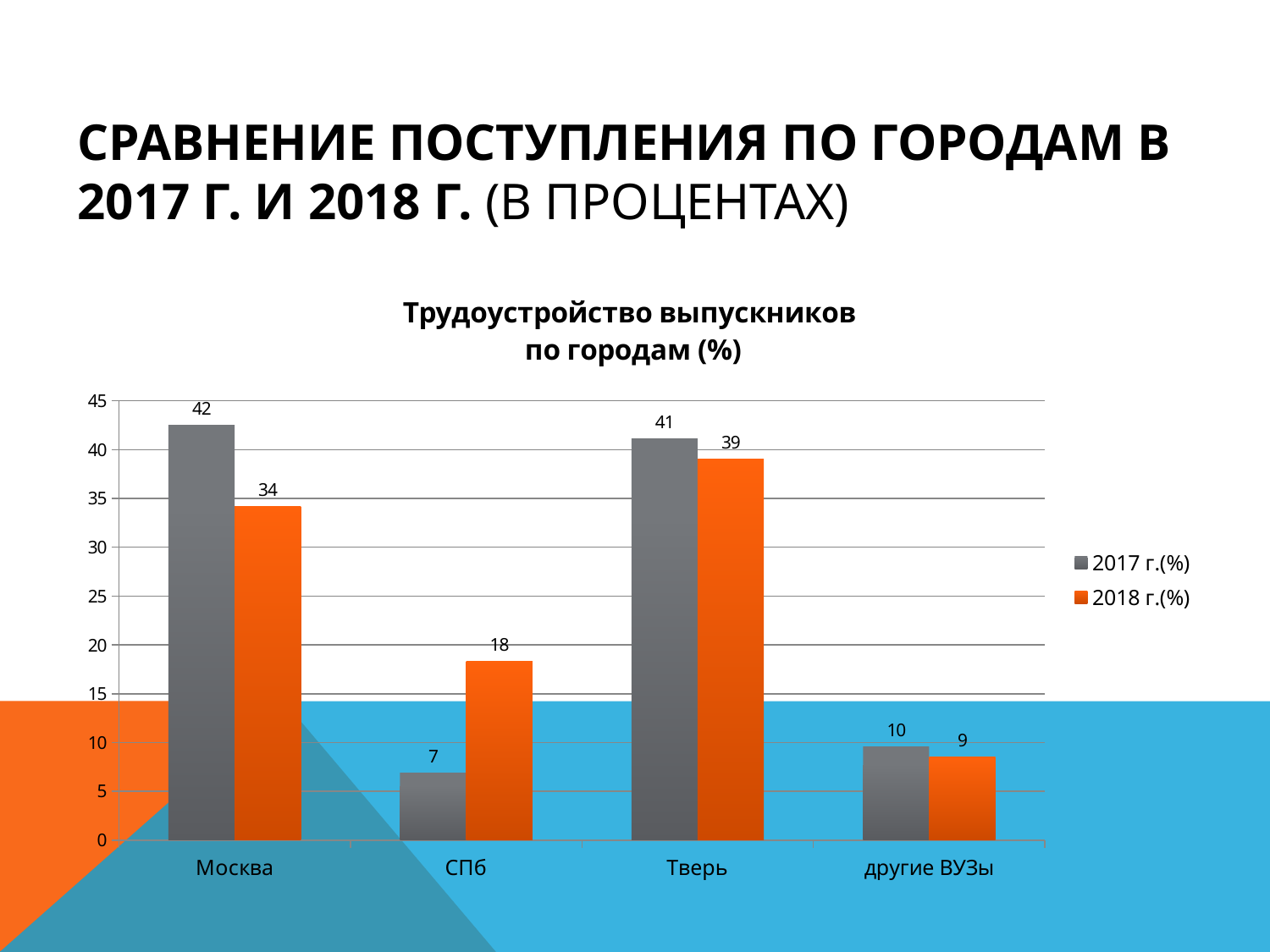
What is the value for СПб in the 2018 г.(%) series? 18 Which is larger for СПб: the 2017 г.(%) value or the 2018 г.(%) value? 2018 г.(%) What is the title of the chart? Трудоустройство выпускников по городам (%) How many categories are shown on the x axis? 4 Which category has the highest value in the 2017 г.(%) series? Москва What kind of chart is shown on the slide? Bar chart What is the value for Тверь in the 2018 г.(%) series? 39 Which category has the lowest value in the 2018 г.(%) series? другие ВУЗы What is the value for другие ВУЗы in the 2017 г.(%) series? 10 What is the difference between the 2017 г.(%) and 2018 г.(%) values for Москва? 8 What is the value for Москва in the 2017 г.(%) series? 42 How many series does the legend list? 2